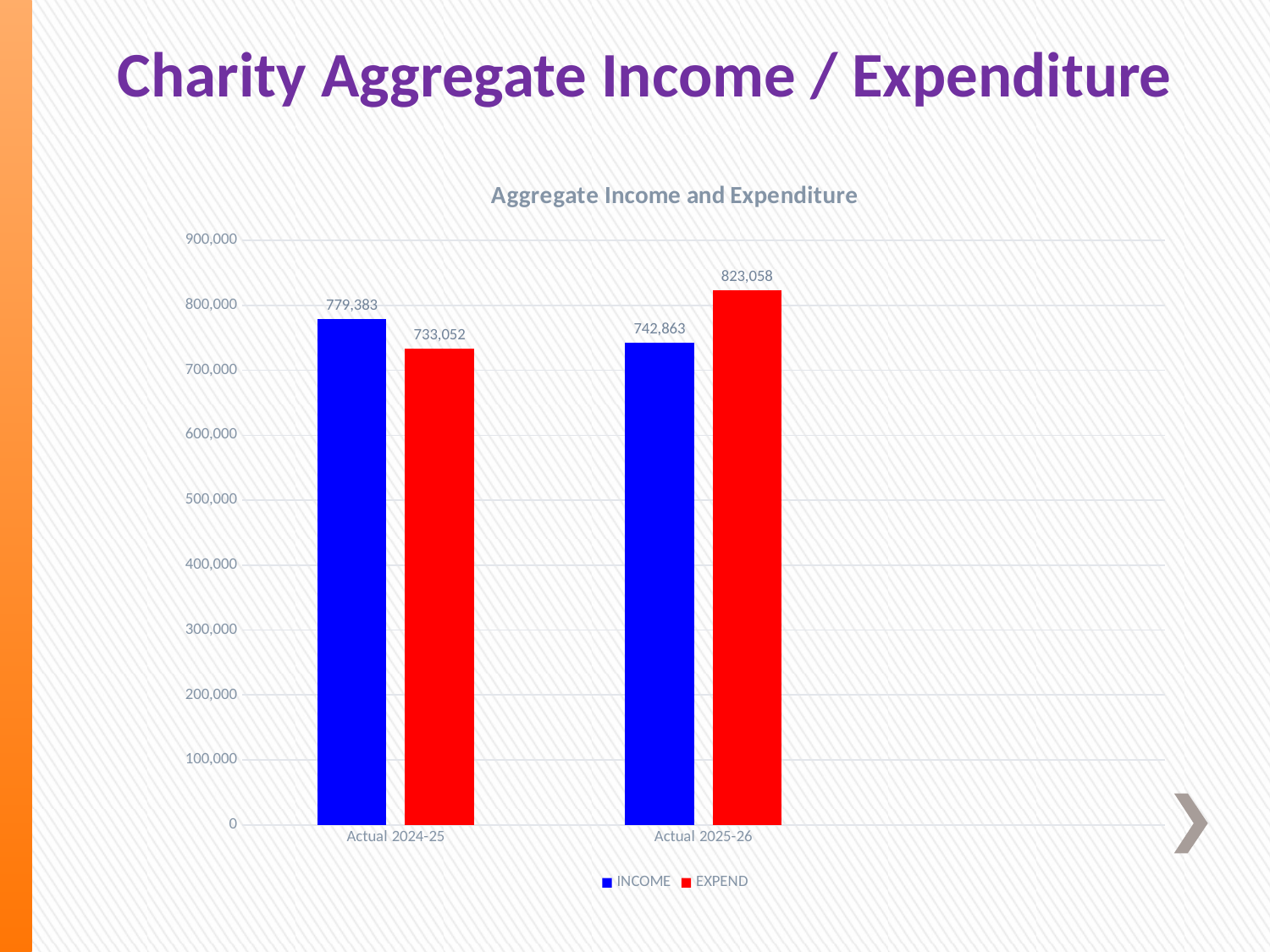
What is the INCOME value for Actual 2025-26? 742,863 What is the difference between INCOME and EXPEND for Actual 2024-25? 46,331 Is INCOME or EXPEND larger for Actual 2025-26? EXPEND What is the EXPEND value for Actual 2025-26? 823,058 What is the INCOME value for Actual 2024-25? 779,383 What kind of chart is shown on the slide? Bar chart Does INCOME rise or fall from Actual 2024-25 to Actual 2025-26? Fall How many series does the legend list? 2 What is the EXPEND value for Actual 2024-25? 733,052 What is the difference between EXPEND and INCOME for Actual 2025-26? 80,195 Which bar has the lowest value on the chart? EXPEND for Actual 2024-25 Which bar has the highest value on the chart? EXPEND for Actual 2025-26